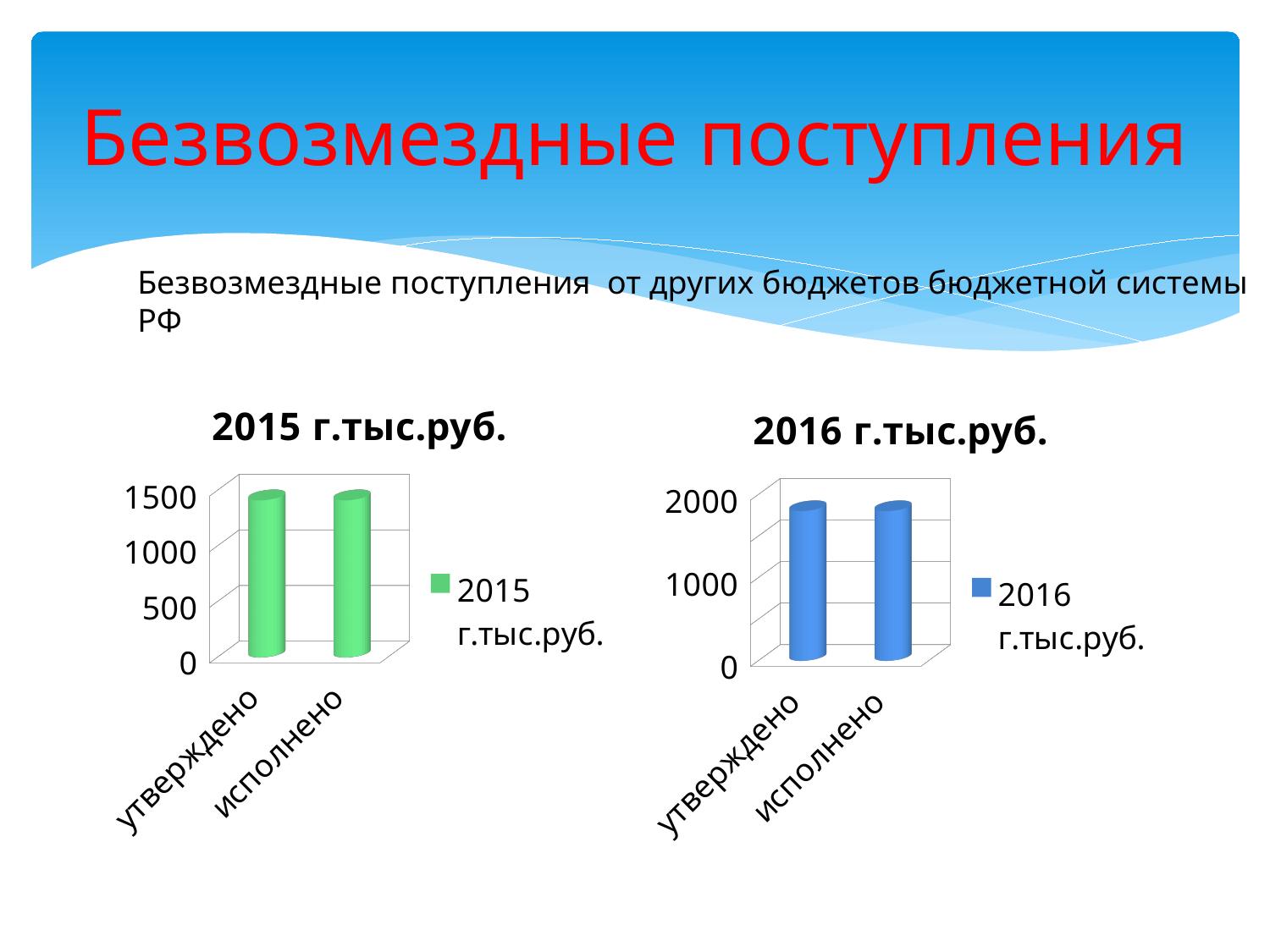
On the chart titled "2015 г.тыс.руб.", is the value for утверждено greater or less than 1000? greater On the chart titled "2015 г.тыс.руб.", what kind of chart is shown? bar chart On the chart titled "2015 г.тыс.руб.", is the value for исполнено greater or less than 500? greater On the chart titled "2016 г.тыс.руб.", how many categories are shown on the x axis? 2 On the chart titled "2016 г.тыс.руб.", how many series does the legend list? 1 On the chart titled "2015 г.тыс.руб.", how many categories are shown on the x axis? 2 On the chart titled "2015 г.тыс.руб.", what is the legend entry? 2015 г.тыс.руб. On the chart titled "2016 г.тыс.руб.", what kind of chart is shown? bar chart On the chart titled "2016 г.тыс.руб.", what colour are the bars? blue On the chart titled "2015 г.тыс.руб.", how many series does the legend list? 1 On the chart titled "2016 г.тыс.руб.", is the value for исполнено greater or less than 2000? less